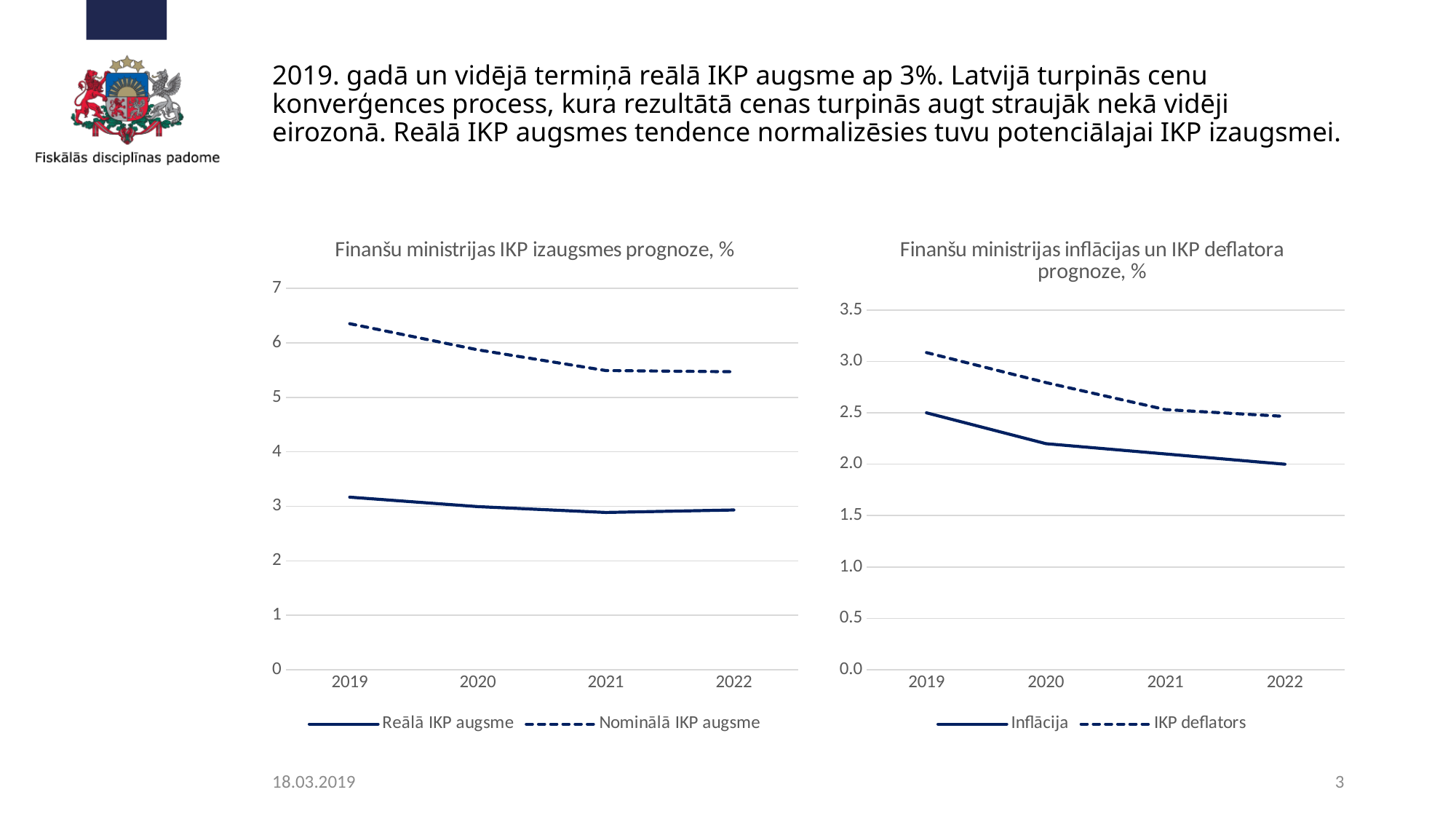
In the right chart, 'Finanšu ministrijas inflācijas un IKP deflatora prognoze, %', how many years are shown on the x axis? 4 What are the two legend entries of the right chart, 'Finanšu ministrijas inflācijas un IKP deflatora prognoze, %'? Inflācija and IKP deflators In the right chart, do the values for IKP deflators rise or fall from 2019 to 2022? fall In the left chart, 'Finanšu ministrijas IKP izaugsmes prognoze, %', how many series does the legend list? 2 In the right chart, what is the value for Inflācija in 2022? 2.0 In the left chart, which series has the larger value in 2019, Reālā IKP augsme or Nominālā IKP augsme? Nominālā IKP augsme In the right chart, is the value for Inflācija in 2020 greater or less than 2.5? less In the right chart, in which year is Inflācija highest? 2019 In the left chart, is the value for Nominālā IKP augsme in 2019 greater or less than 6? greater In the left chart, in which year is Reālā IKP augsme highest? 2019 In the left chart, is the value for Reālā IKP augsme in 2021 greater or less than 3? less What kind of chart is the left chart, 'Finanšu ministrijas IKP izaugsmes prognoze, %'? line chart